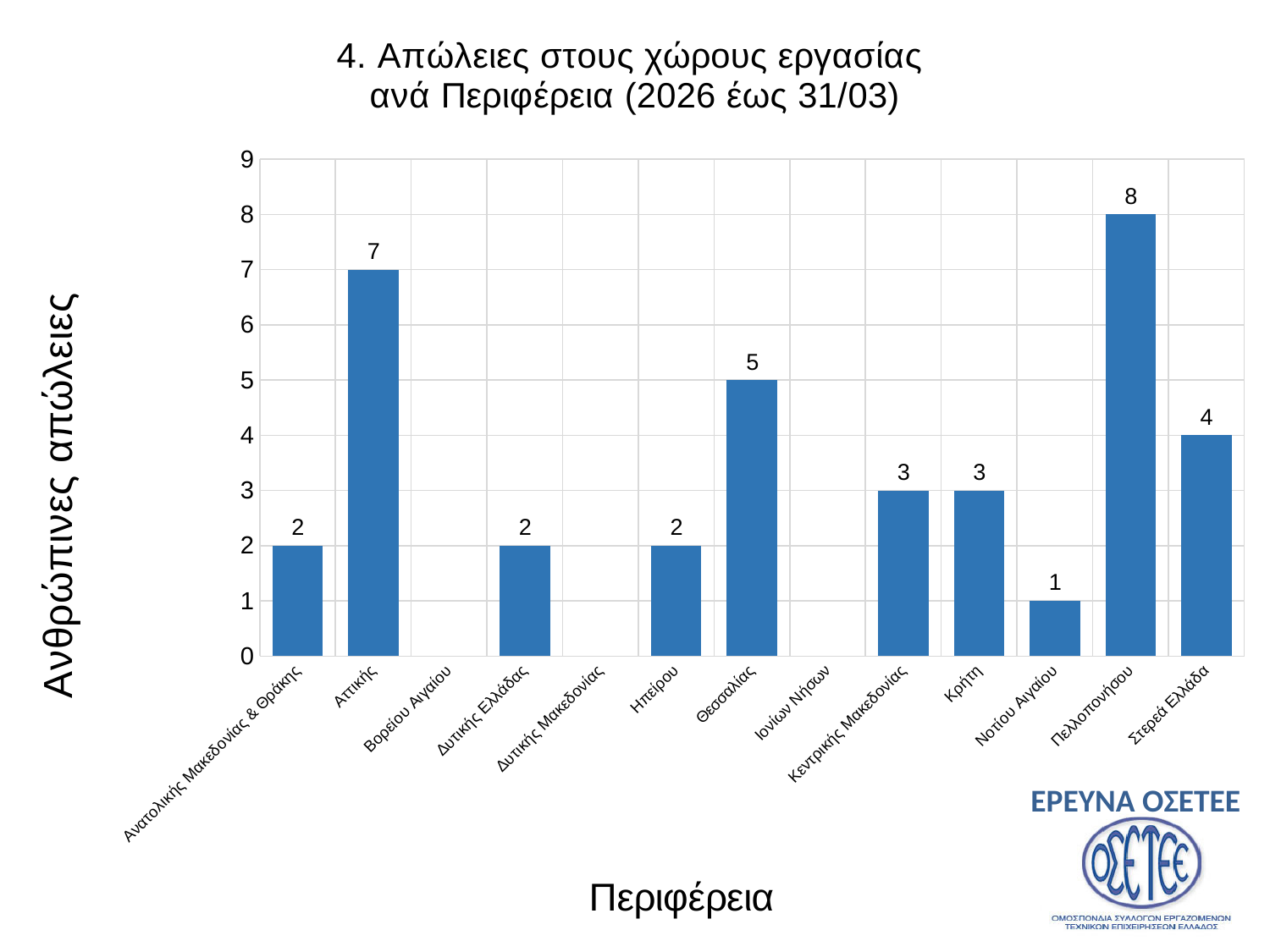
What is the value for Πελοποννήσου? 8 How many regions are listed on the x axis? 13 Is the value for Αττικής greater or less than 5? greater Which is larger, the value for Αττικής or the value for Θεσσαλίας? Αττικής What is the value for Αττικής? 7 What is the difference between the values for Πελοποννήσου and Αττικής? 1 What is the value for Νοτίου Αιγαίου? 1 What is the value for Θεσσαλίας? 5 What is the value for Στερεά Ελλάδα? 4 What is the difference between the values for Θεσσαλίας and Κρήτη? 2 What kind of chart is shown on the slide? bar chart Which region has the highest value? Πελλοπονήσου